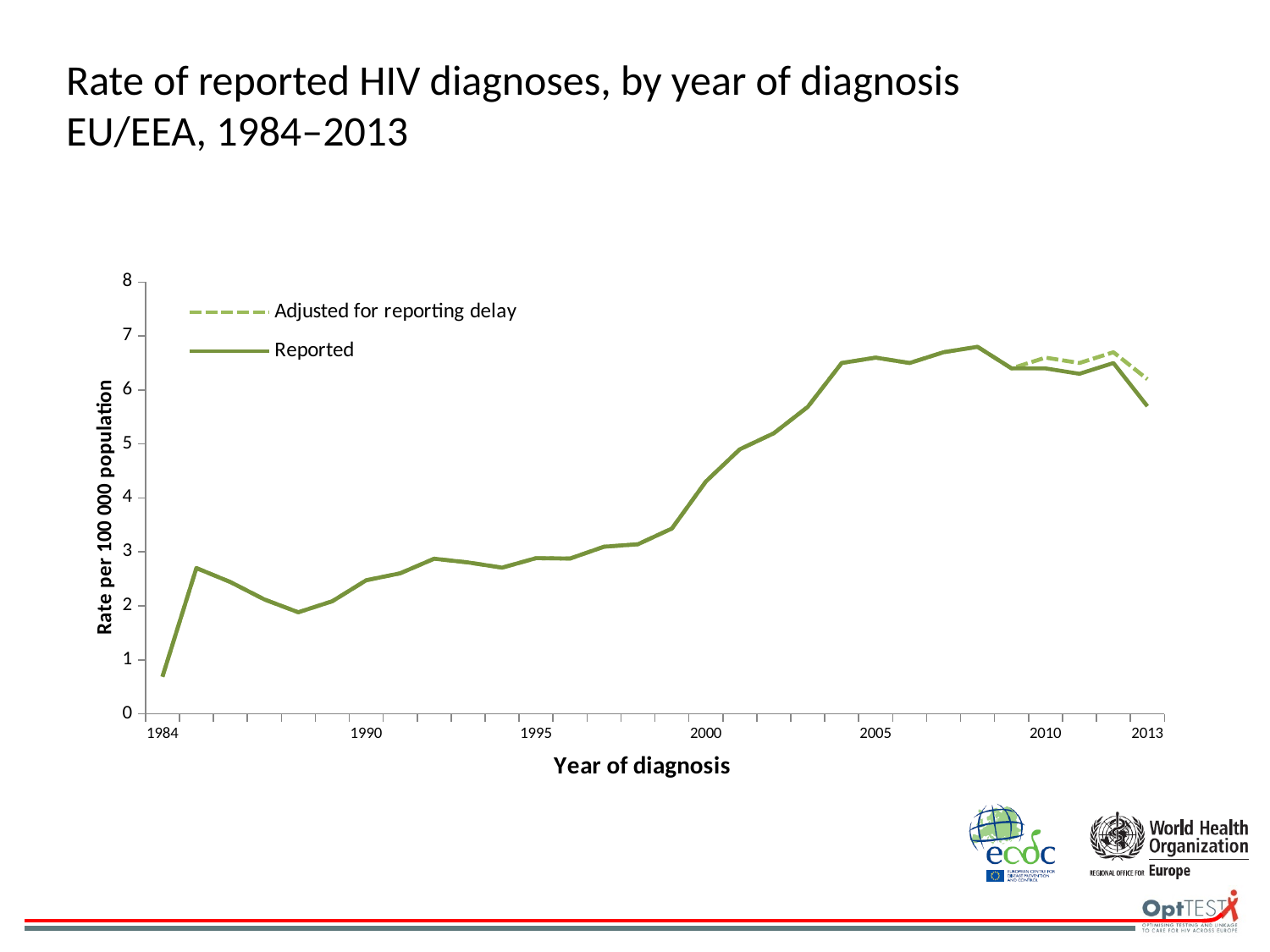
In which year is the Reported rate lowest? 1984 What is the title of the vertical axis? Rate per 100 000 population Is the Reported value for 2013 greater or less than 6? less Is the Reported value for 2005 greater or less than 6? greater What are the two series named in the legend? Adjusted for reporting delay; Reported What kind of chart is shown on the slide? line chart Is the Reported value for 1990 greater or less than 2? greater Does the Reported rate rise or fall between 1999 and 2004? rise Which year has the higher Reported rate, 1984 or 2013? 2013 How many series does the legend list? 2